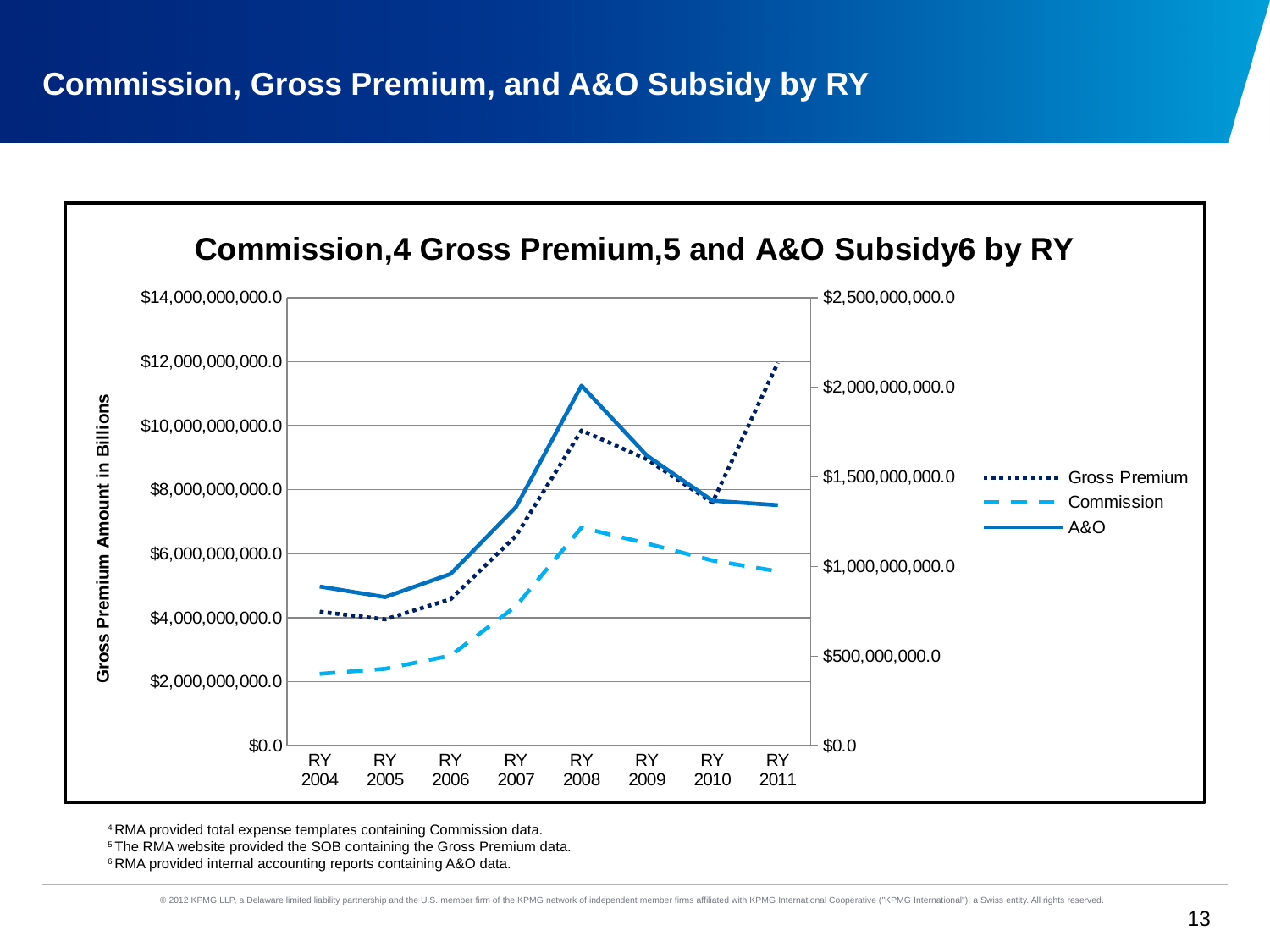
Does the Commission series rise or fall from RY 2004 to RY 2008? rise How many series does the chart legend list? 3 In which RY does the Gross Premium series reach its highest value? RY 2011 In which RY does the A&O series reach its highest value? RY 2008 What is the label on the left vertical axis? Gross Premium Amount in Billions In which RY does the Commission series reach its highest value? RY 2008 How many reinsurance years (RY) are plotted along the x axis? 8 Which series are listed in the chart legend? Gross Premium, Commission, A&O What kind of chart is shown on the slide? Line chart In which RY is the Commission series at its lowest value? RY 2004 Is the Gross Premium value for RY 2011 larger or smaller than the Gross Premium value for RY 2008? larger Is the Gross Premium value for RY 2011 greater or less than $10,000,000,000.0 on the left axis? greater